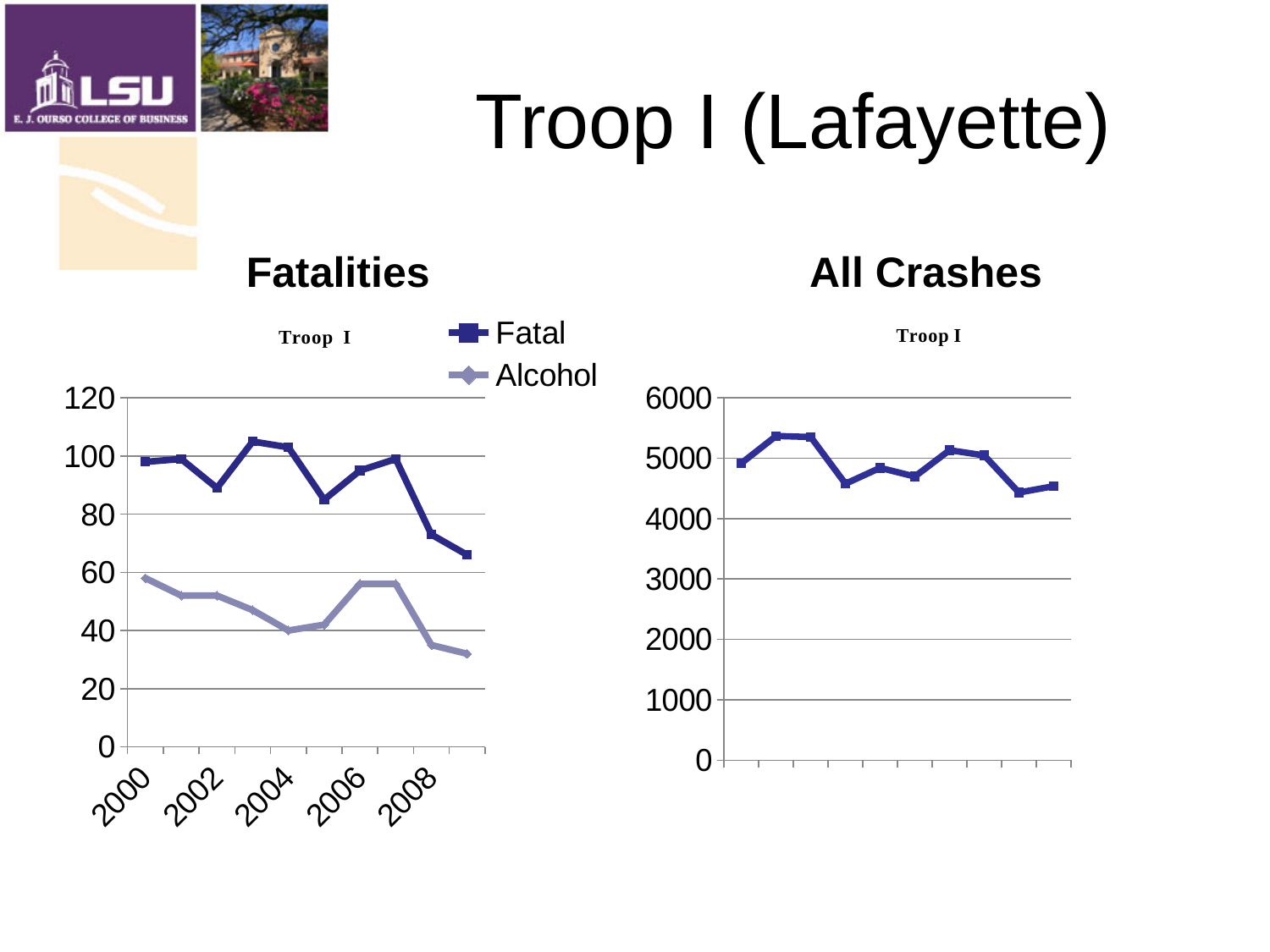
On the Fatalities chart, is the Alcohol value for 2000 greater or less than 40? greater On the Fatalities chart, is the Alcohol value for 2008 greater or less than 40? less On the Fatalities chart, what are the two series named in the legend? Fatal and Alcohol On the Fatalities chart, which series has the higher value in 2004, Fatal or Alcohol? Fatal On the Fatalities chart, is the Fatal value for 2009 greater or less than 80? less On the Fatalities chart, how many data points does the Fatal line have? 10 On the Fatalities chart, what kind of chart is used? line chart On the Fatalities chart, in which year is the Fatal value lowest? 2009 On the Fatalities chart, how many series does the legend list? 2 On the Fatalities chart, does the Fatal line rise or fall from 2007 to 2009? fall